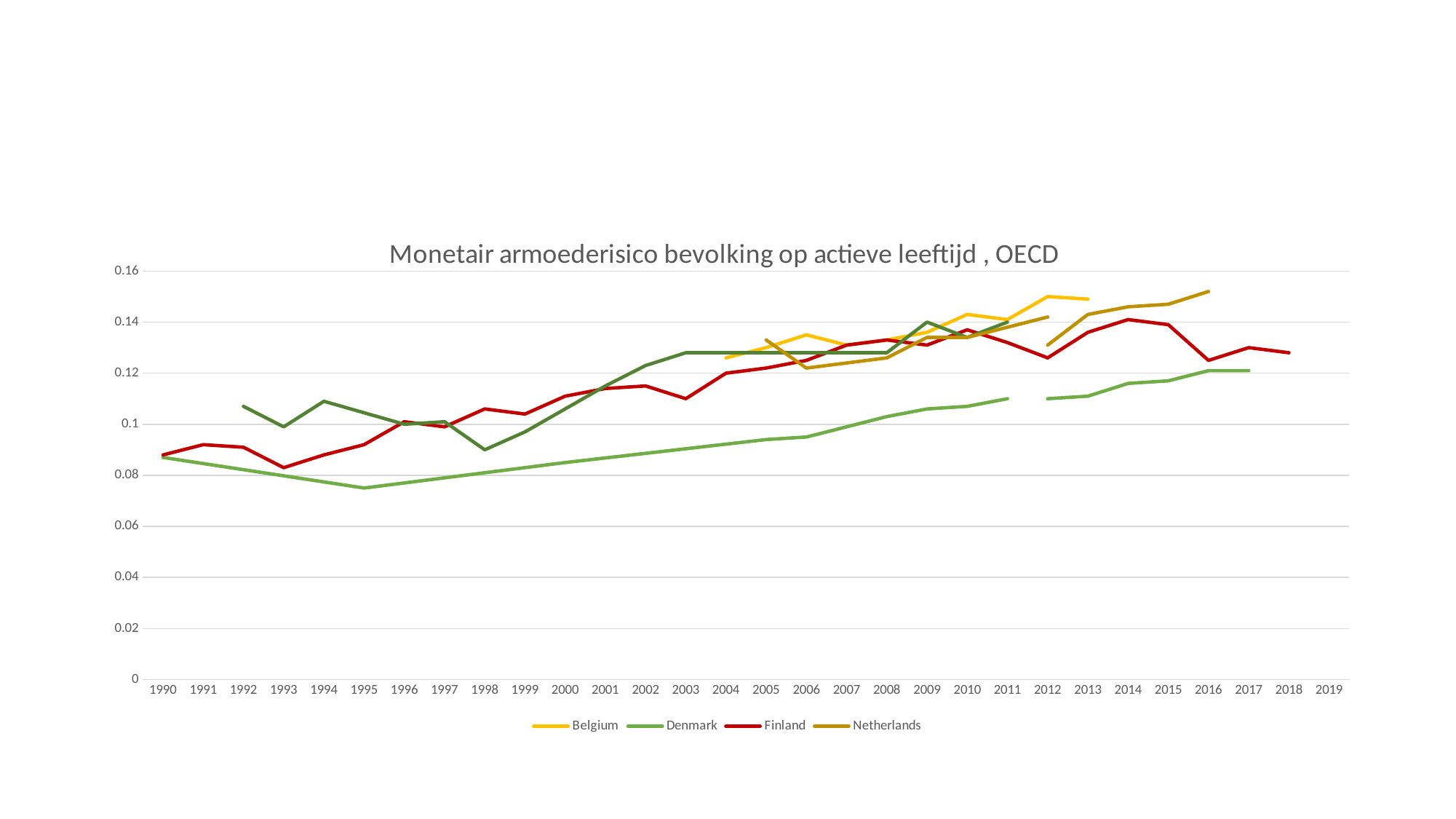
What is the title of the chart? Monetair armoederisico bevolking op actieve leeftijd , OECD Which series has the lowest value in 2012? Denmark Does the Denmark line generally rise or fall from 1995 to 2017? rise Which series is shown in red in the legend? Finland Is the value for Netherlands in 2016 greater or less than 0.14? greater What kind of chart is shown on the slide? line chart In 2016, which is larger: the value for Netherlands or the value for Finland? Netherlands In 2017, which is larger: the value for Finland or the value for Denmark? Finland Is the value for Denmark in 1995 greater or less than 0.08? less Is the value for Finland in 2018 greater or less than 0.12? greater How many series does the legend list? 4